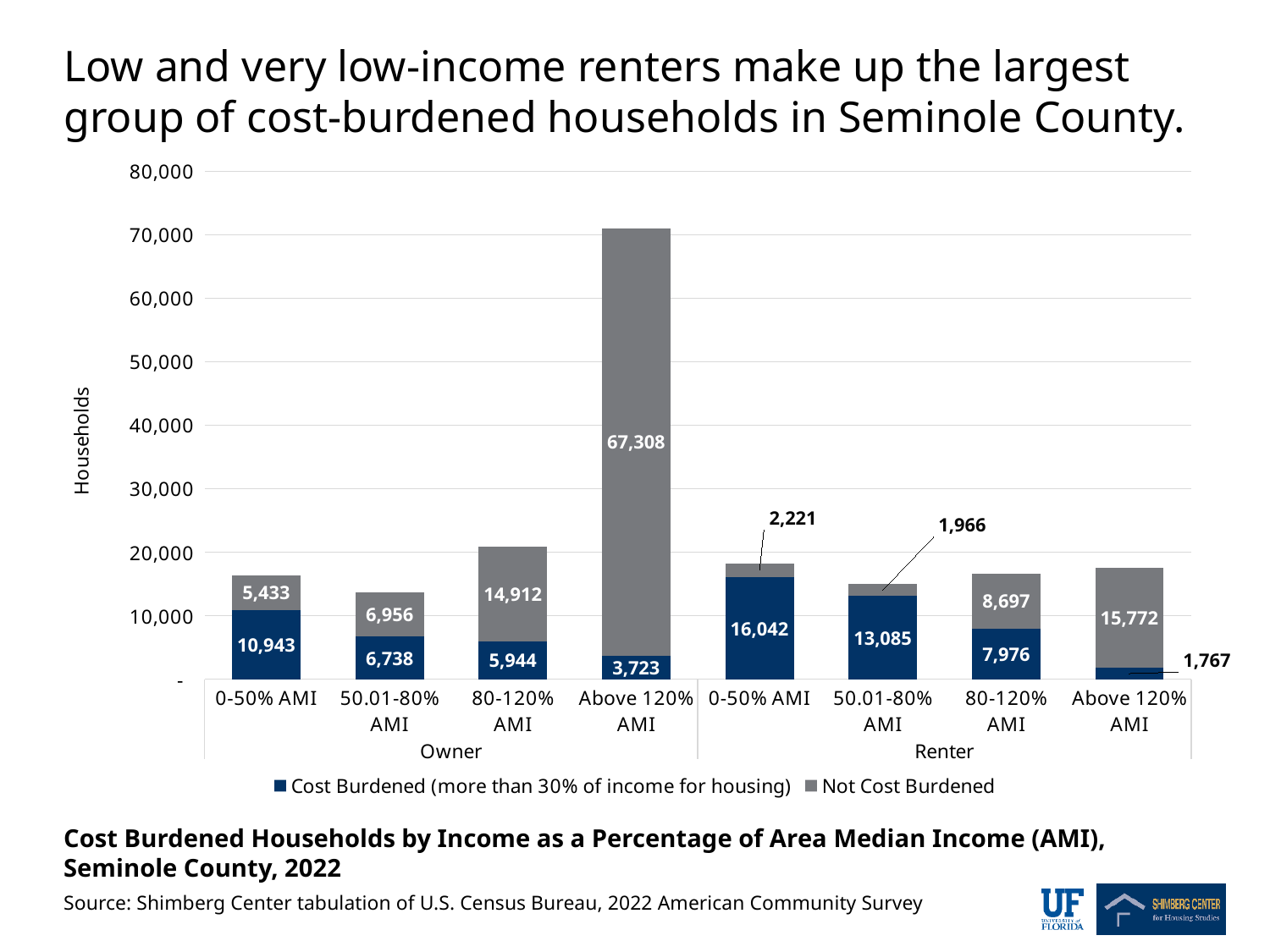
How many income categories (bars) are plotted in total across Owner and Renter? 8 What is the number of Not Cost Burdened households for Owner Above 120% AMI? 67,308 What is the number of Cost Burdened households for Renter 0-50% AMI? 16,042 How many series does the legend list? 2 What is the difference between Cost Burdened households for Renter 0-50% AMI and Owner 0-50% AMI? 5,099 Which is larger: Cost Burdened households for Owner 50.01-80% AMI or Renter 50.01-80% AMI? Renter 50.01-80% AMI Which category has the highest number of Cost Burdened households? Renter 0-50% AMI What kind of chart is shown on the slide? Stacked bar chart What is the total number of households (Cost Burdened plus Not Cost Burdened) for Renter 0-50% AMI? 18,263 What is the title of the chart shown below the plot? Cost Burdened Households by Income as a Percentage of Area Median Income (AMI), Seminole County, 2022 Which category has the lowest number of Cost Burdened households? Renter Above 120% AMI What is the number of Cost Burdened households for Owner 80-120% AMI? 5,944